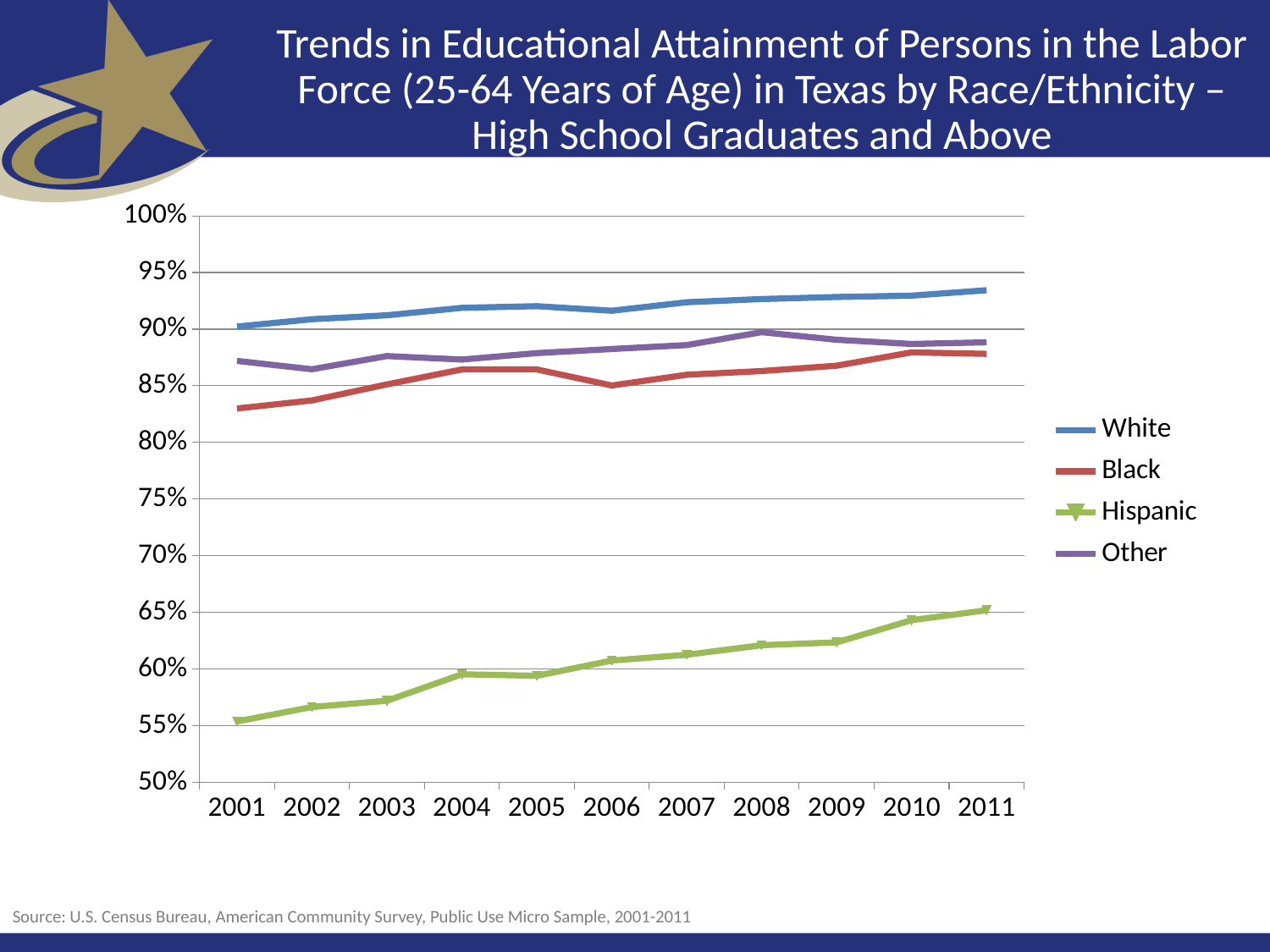
Is the value for Black in 2001 greater or less than 85%? less Is the value for White in 2011 greater or less than 90%? greater How many years are shown along the x axis? 11 What kind of chart is shown on the slide? line chart Does the Hispanic series generally rise or fall from 2001 to 2011? rise Which series has the highest values across the chart? White What colour is the line for the Hispanic series? green In 2006, which is larger, the value for Black or the value for Other? Other How many series does the legend list? 4 Which series has the lowest values across the chart? Hispanic Is the value for Hispanic in 2001 greater or less than 60%? less